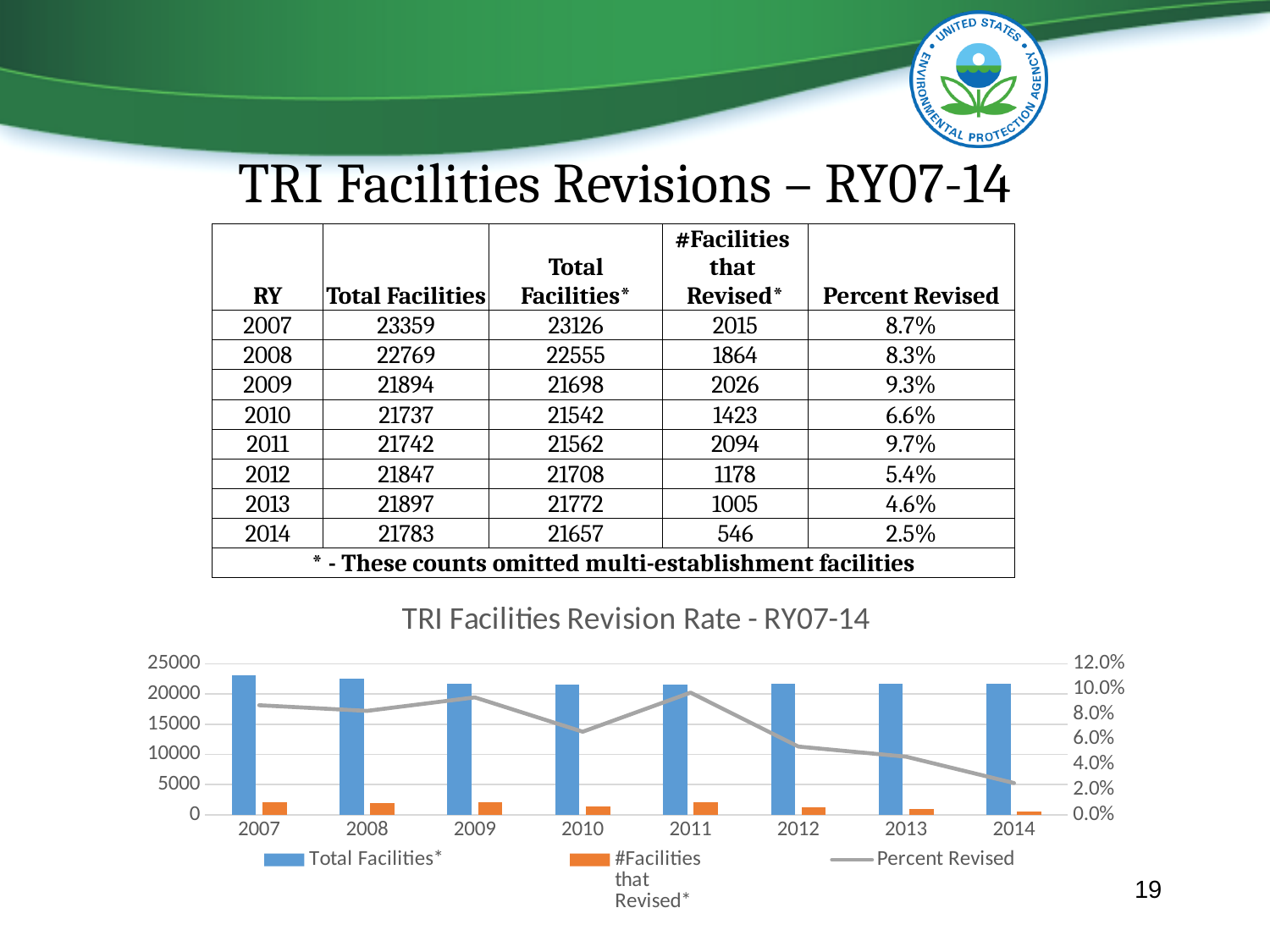
In which year is the Percent Revised line at its lowest? 2014 Does the Percent Revised line rise or fall from 2011 to 2014? fall Is the Total Facilities* bar for 2007 greater or less than 20000? greater Is the Percent Revised value for 2013 greater or less than 6.0%? less How many reporting years are plotted on the x axis of the chart? 8 In which year is the Percent Revised line at its highest? 2011 How many series does the chart legend list? 3 What kind of chart is shown at the bottom of the slide? A bar chart with a line Which year has the larger #Facilities that Revised* bar, 2011 or 2012? 2011 What is the difference between the Percent Revised values for 2007 and 2014? 6.2% What is the #Facilities that Revised* value for 2011? 2094 What is the Percent Revised value for 2014? 2.5%